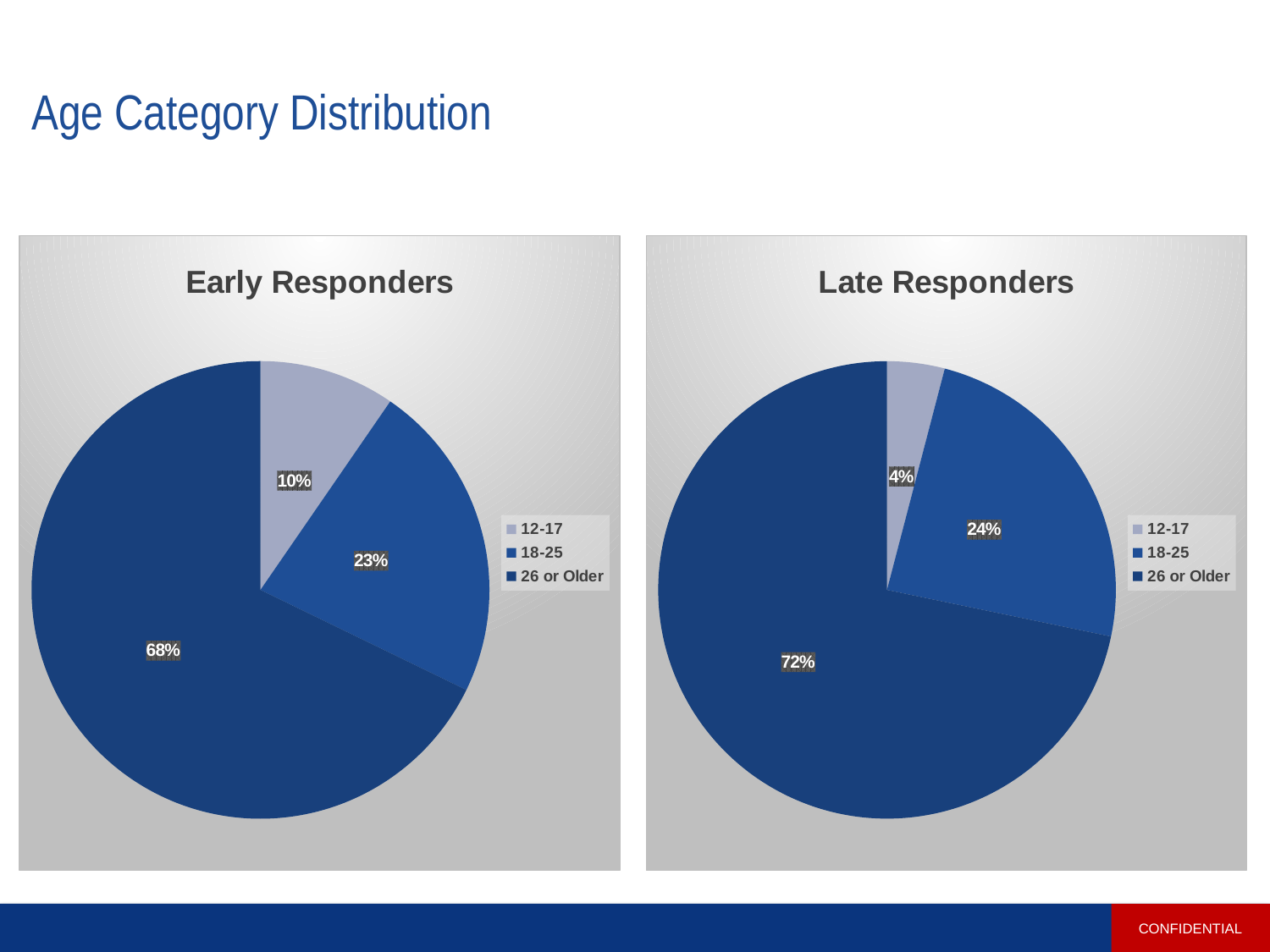
What is the title of the slide? Age Category Distribution In the Late Responders chart, which age category has the smallest share? 12-17 How many age categories does the legend of the Early Responders chart list? 3 In the Early Responders chart, what share of responders are aged 18-25? 23% What is the difference between the 26 or Older share in the Late Responders chart and the 26 or Older share in the Early Responders chart? 4% Which chart has the larger share for the 12-17 category, Early Responders or Late Responders? Early Responders What type of chart is the Late Responders chart? Pie chart In the Early Responders chart, what is the difference between the 26 or Older share and the 18-25 share? 45% In the Late Responders chart, what share of responders are 26 or Older? 72% In the Early Responders chart, which age category has the largest share? 26 or Older In the Late Responders chart, what share of responders are aged 12-17? 4% In the Early Responders chart, what share of responders are aged 12-17? 10%